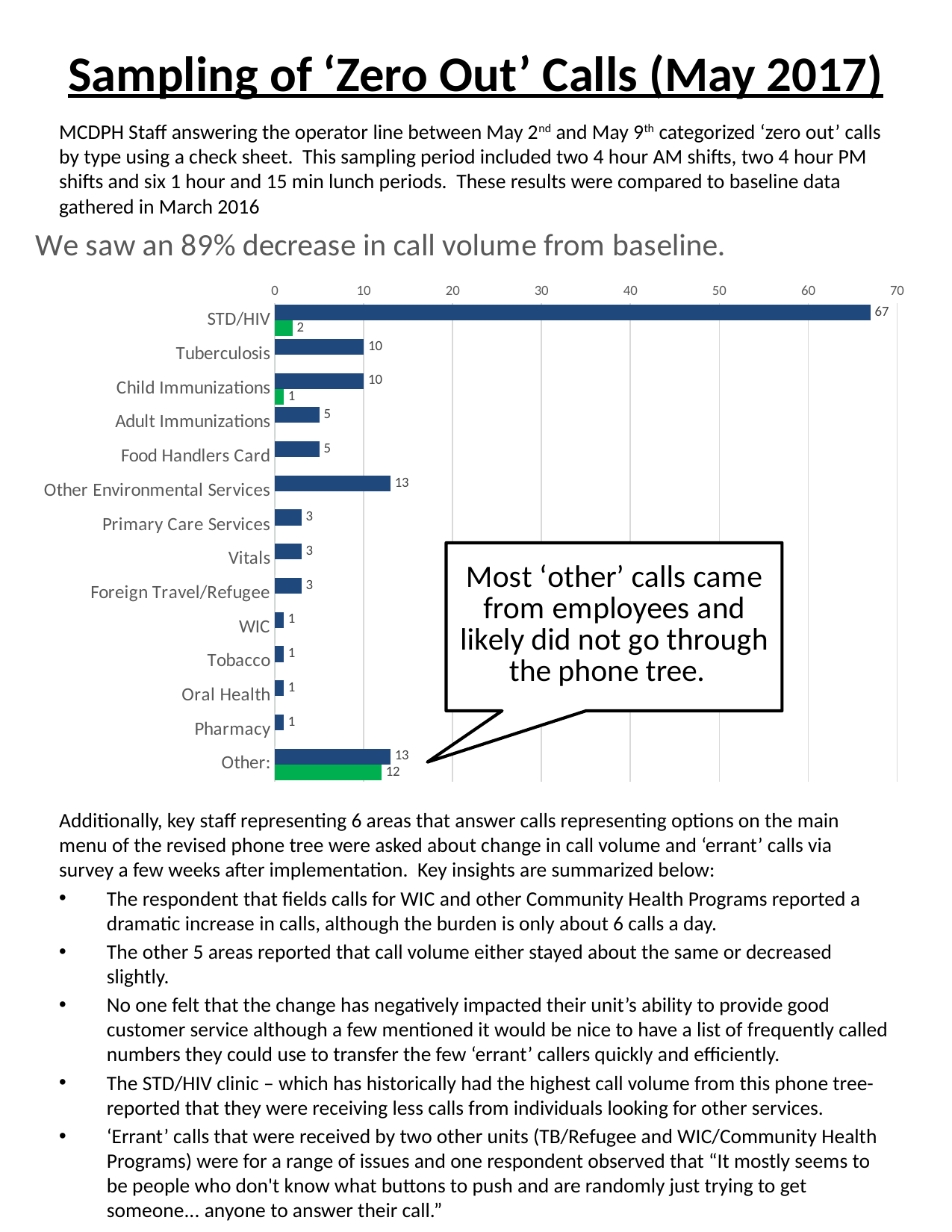
What is the value of the green bar for STD/HIV? 2 What is the difference between the blue bar values for STD/HIV and Tuberculosis? 57 What is the difference between the blue bar and the green bar for Child Immunizations? 9 Which is larger, the blue bar for Adult Immunizations or the blue bar for Other Environmental Services? Other Environmental Services Is the blue bar value for STD/HIV greater or less than 60? greater What type of chart is shown on the slide? bar chart What is the value of the green bar for Other:? 12 Which category has the highest blue bar value? STD/HIV What is the value of the blue bar for STD/HIV? 67 How many categories are listed on the chart's vertical axis? 14 What does the callout box on the chart say about 'other' calls? Most 'other' calls came from employees and likely did not go through the phone tree. What is the value of the blue bar for Other Environmental Services? 13